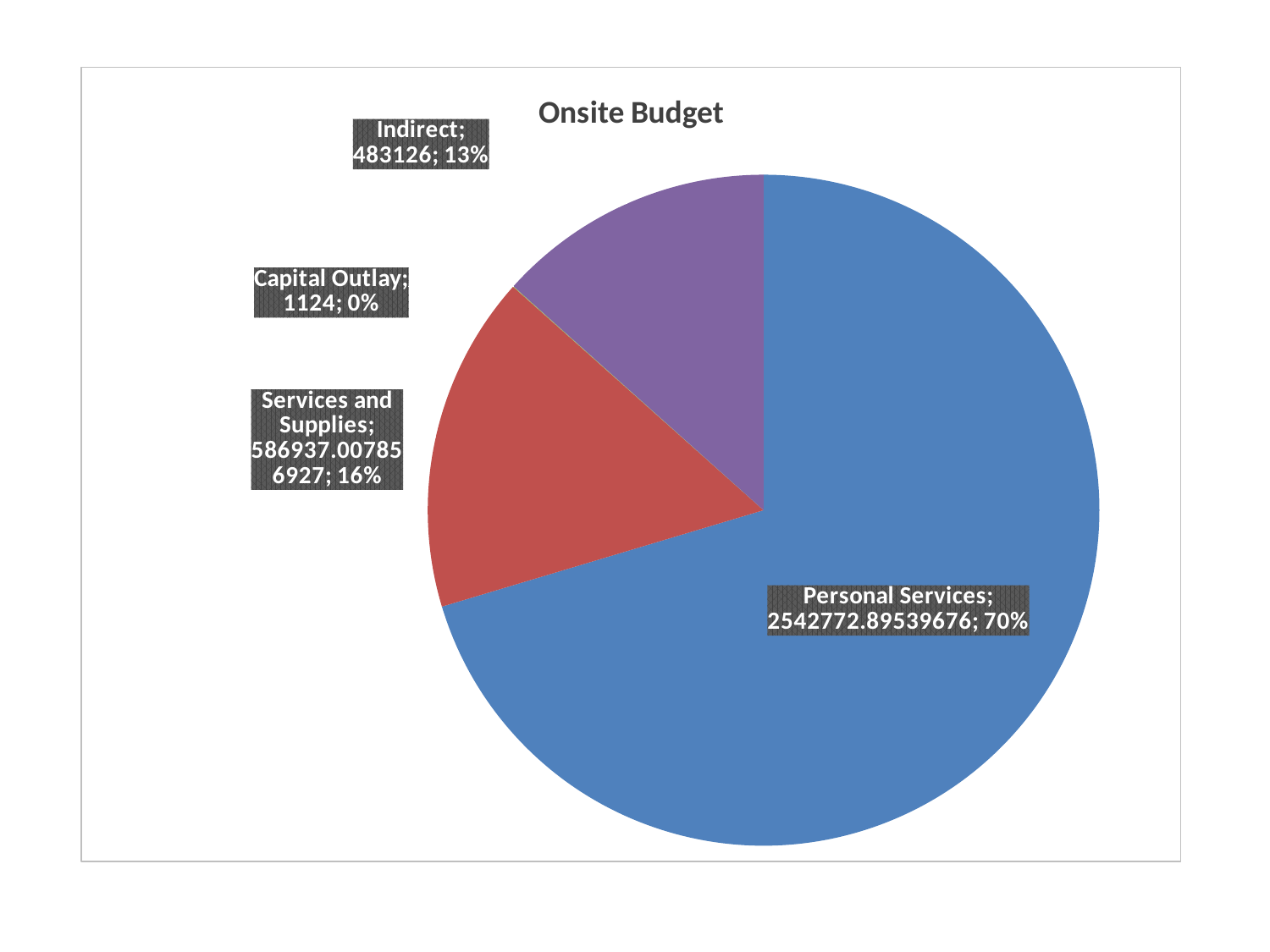
What colour is the Personal Services slice? blue What value is shown for Capital Outlay? 1124 What percentage share does Personal Services have? 70% What is the title of the chart? Onsite Budget Which is larger, Services and Supplies or Indirect? Services and Supplies Which category has the largest share of the budget? Personal Services What type of chart is shown on the slide? pie chart How many slices does the pie chart have? 4 Which category has the smallest share of the budget? Capital Outlay What value is shown for Indirect? 483126 What percentage share does Indirect have? 13% What percentage share does Services and Supplies have? 16%